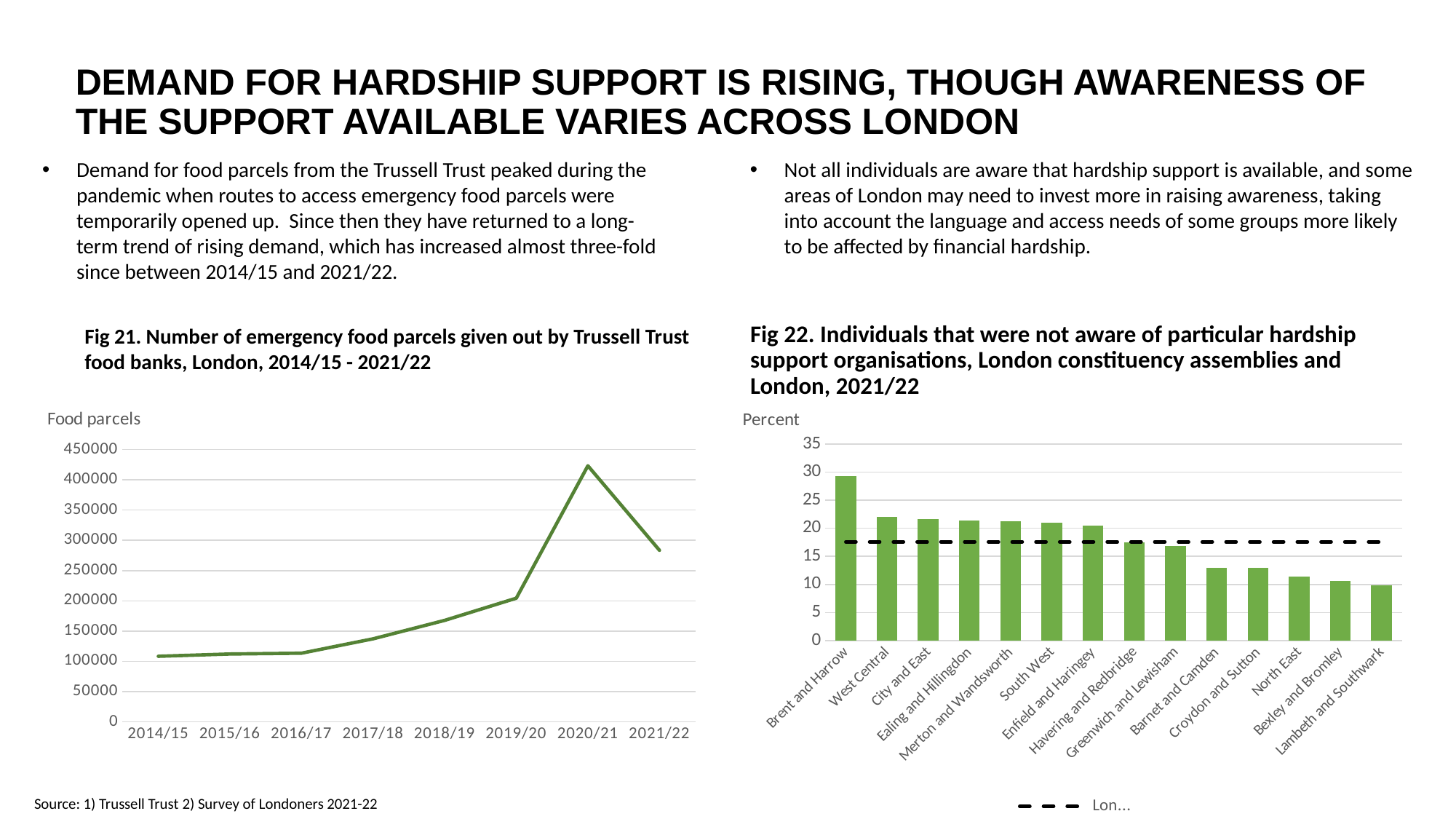
In Fig 22, which is larger, the value for Barnet and Camden or the value for West Central? West Central In Fig 22, is the value for Brent and Harrow greater or less than 25? greater What kind of chart is Fig 22? bar chart In Fig 21, is the value for 2020/21 greater or less than 400000? greater In Fig 21, is the value for 2014/15 greater or less than 100000? greater In Fig 21, which year has the highest number of food parcels? 2020/21 In Fig 22, which constituency assembly has the highest percentage? Brent and Harrow What kind of chart is Fig 21? line chart In Fig 22, how many constituency assemblies are shown as bars? 14 In Fig 21, how many financial years are plotted along the x axis? 8 In Fig 21, do the values rise or fall between 2014/15 and 2020/21? rise